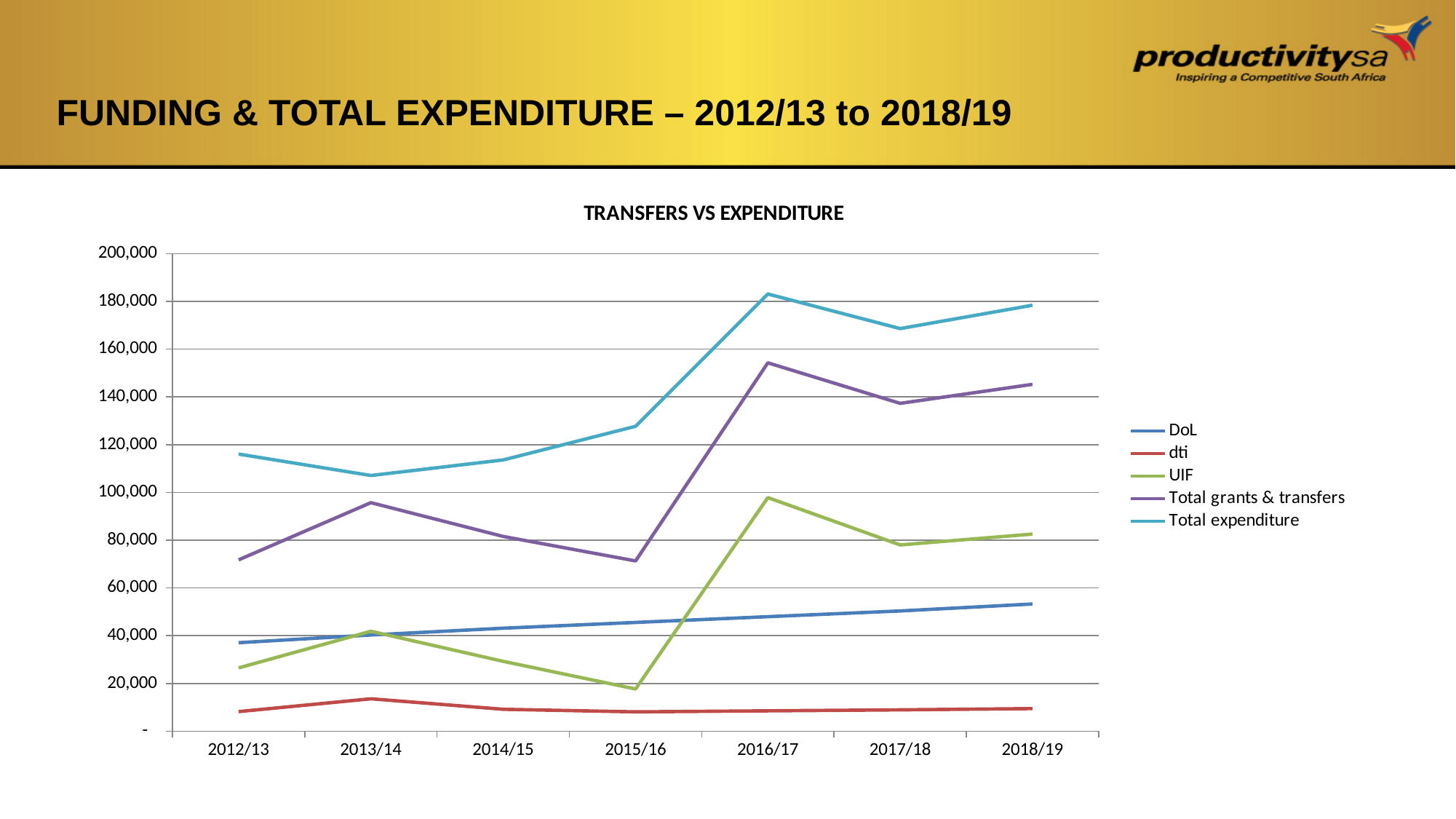
Does the DoL line rise or fall from 2012/13 to 2018/19? rise Which series has the highest values across all years? Total expenditure What kind of chart is shown on the slide? line chart How many series does the legend list? 5 In which year does UIF reach its highest value? 2016/17 Which series has the lowest values across all years? dti What is the title of the chart? TRANSFERS VS EXPENDITURE Is the value for Total grants & transfers in 2015/16 greater or less than 80,000? less Is the value for Total expenditure in 2016/17 greater or less than 160,000? greater In 2012/13, which is larger: DoL or UIF? DoL In which year is Total expenditure at its lowest? 2013/14 How many financial years are plotted along the x axis? 7